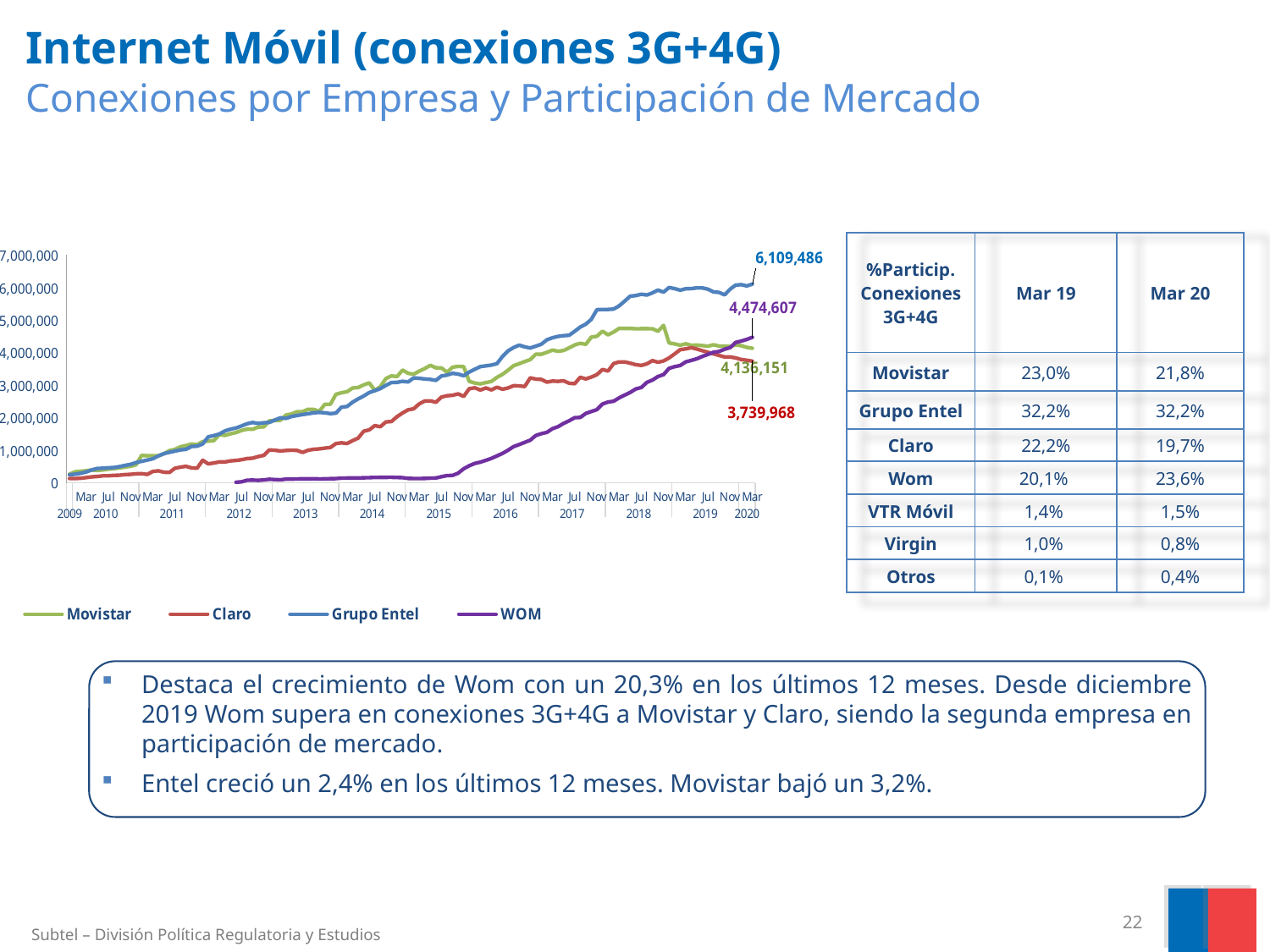
At the end of the line chart, which is larger: the value for WOM or the value for Movistar? WOM Which series has the highest value at the end of the line chart (Mar 2020)? Grupo Entel What kind of chart is shown on the left of the slide? Line chart Which series has the lowest value at the end of the line chart (Mar 2020)? Claro What is the final labelled value for Grupo Entel on the line chart? 6,109,486 What is the final labelled value for Movistar on the line chart? 4,136,151 What is the difference between the final labelled values of Grupo Entel and WOM? 1,634,879 Is the value for WOM in 2015 greater or less than 1,000,000? less What is the final labelled value for Claro on the line chart? 3,739,968 What is the final labelled value for WOM on the line chart? 4,474,607 How many series does the legend of the line chart list? 4 What is the difference between the final labelled values of Movistar and Claro? 396,183